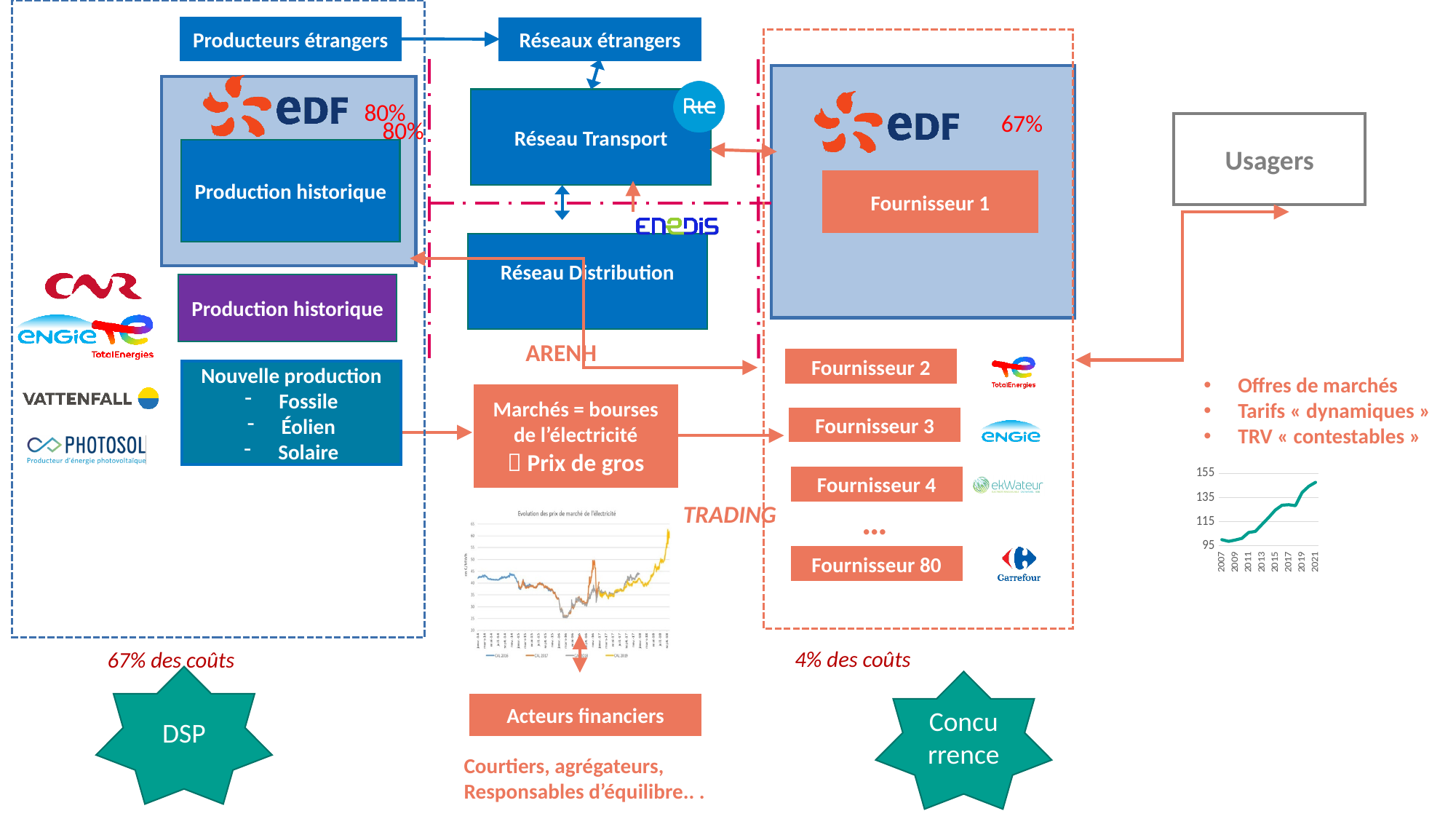
What is the title of the chart shown in the middle of the slide, below the 'Marchés = bourses de l'électricité' box? Evolution des prix de marché de l'électricité What kind of chart is the 'Evolution des prix de marché de l'électricité' chart in the middle of the slide? line chart In the line chart at the bottom right of the slide, is the value for 2007 greater or less than 115? less How many year labels are shown on the x axis of the line chart at the bottom right of the slide? 8 In the line chart at the bottom right of the slide, which is larger, the value for 2009 or the value for 2019? 2019 What kind of chart is the small chart at the bottom right of the slide, below the 'Usagers' bullet points? line chart In the line chart at the bottom right of the slide, is the value for 2015 greater or less than 115? greater In the line chart at the bottom right of the slide, is the value for 2021 greater or less than 135? greater In the line chart at the bottom right of the slide, which year shown on the x axis has the highest value? 2021 In the line chart at the bottom right of the slide, do the values rise or fall from 2007 to 2021? rise